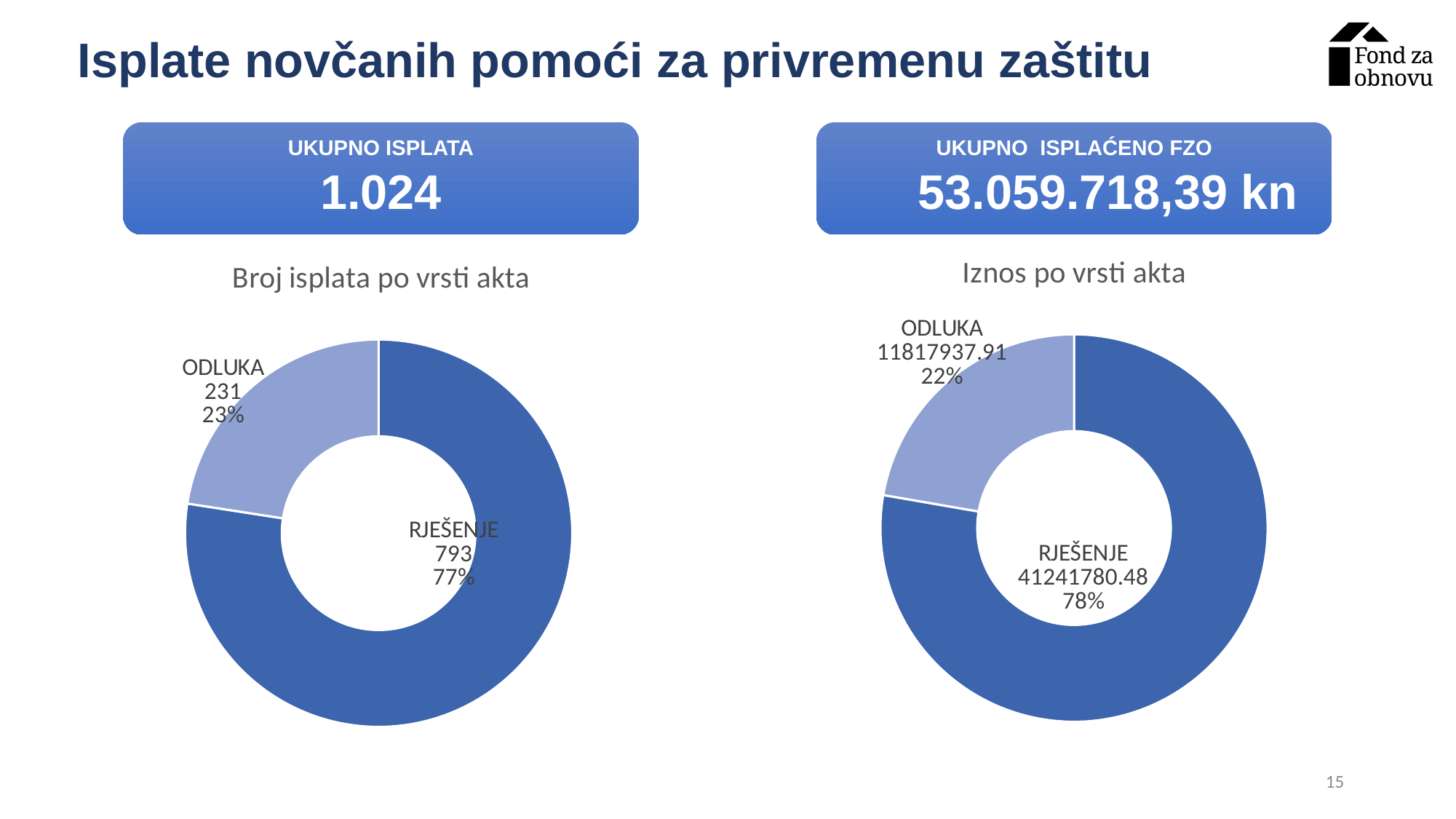
In the chart 'Iznos po vrsti akta', what is the value for ODLUKA? 11817937.91 In the chart 'Iznos po vrsti akta', what is the value for RJEŠENJE? 41241780.48 In the chart 'Broj isplata po vrsti akta', what is the difference between RJEŠENJE and ODLUKA? 562 In the chart 'Broj isplata po vrsti akta', what share of the total does ODLUKA represent? 23% In the chart 'Iznos po vrsti akta', which is larger, ODLUKA or RJEŠENJE? RJEŠENJE In the chart 'Broj isplata po vrsti akta', what is the value for ODLUKA? 231 What kind of chart is 'Iznos po vrsti akta'? Doughnut chart How many categories are shown in the chart 'Broj isplata po vrsti akta'? 2 In the chart 'Iznos po vrsti akta', which category has the smallest value? ODLUKA In the chart 'Iznos po vrsti akta', what share of the total does RJEŠENJE represent? 78% In the chart 'Broj isplata po vrsti akta', which category has the largest value? RJEŠENJE In the chart 'Broj isplata po vrsti akta', what is the value for RJEŠENJE? 793